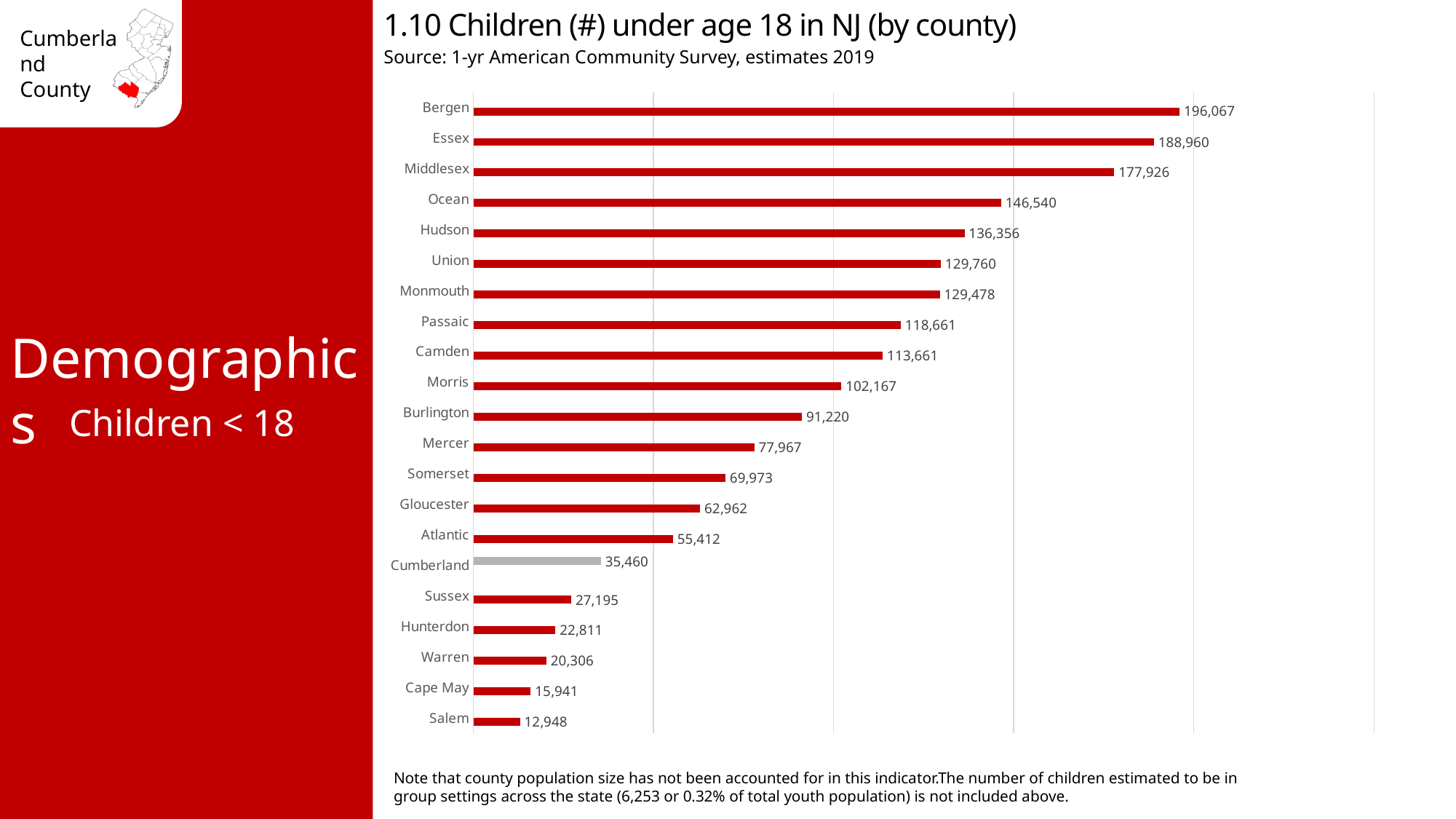
Which county has the highest number of children under age 18? Bergen Which county has the lowest number of children under age 18? Salem What is the value shown for Salem County? 12,948 What type of chart is shown on the slide? bar chart What is the difference between the values for Cumberland and Salem? 22,512 Which county's bar is coloured grey instead of red? Cumberland How many children under age 18 are in Cumberland County? 35,460 What is the value shown for Morris County? 102,167 Which county has a larger value, Ocean or Hudson? Ocean What is the value shown for Bergen County? 196,067 What is the difference between the values for Bergen and Essex? 7,107 How many counties are shown in the chart? 21